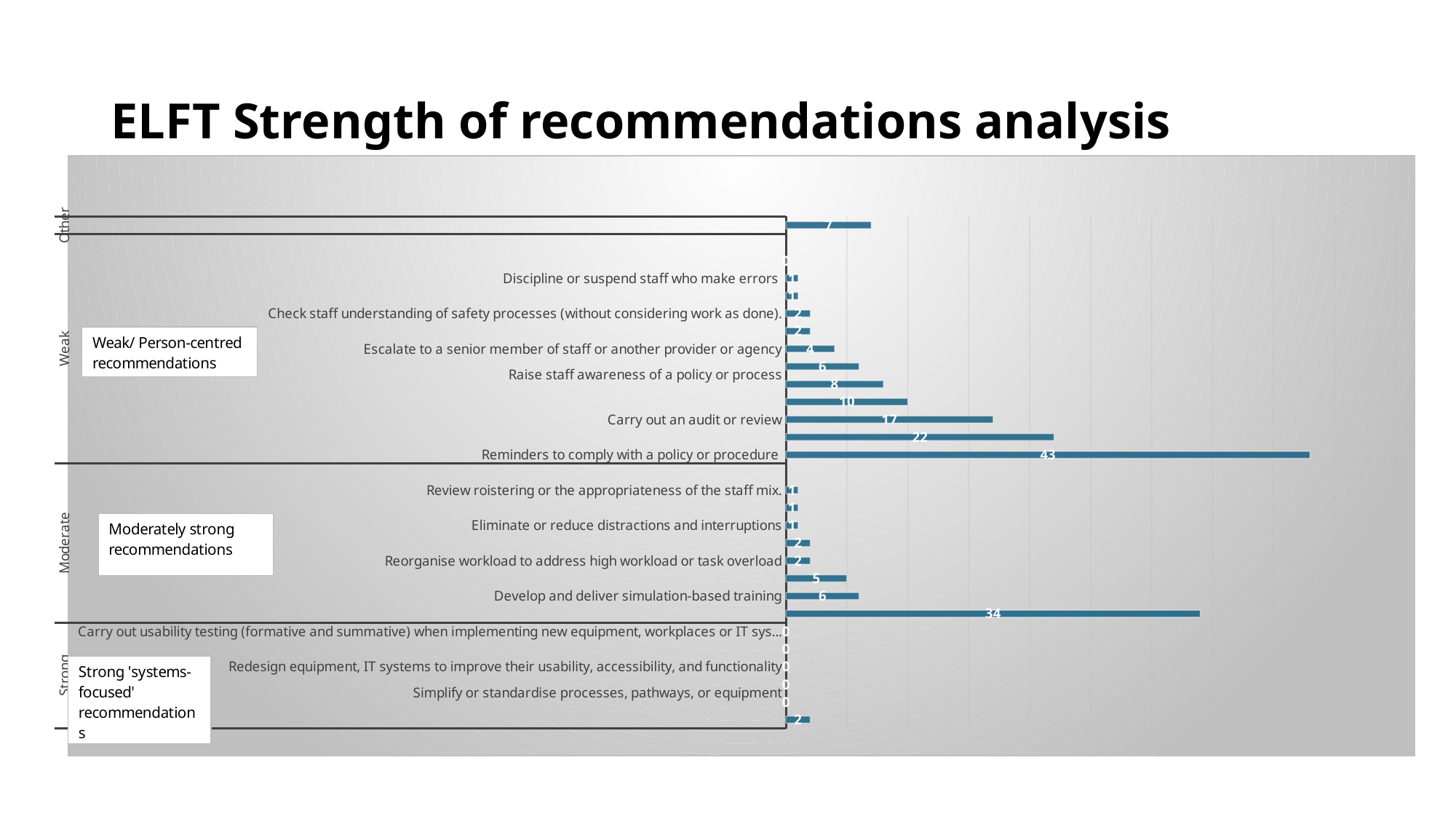
What is the value for 'Simplify or standardise processes, pathways, or equipment'? 0 What is the title of the slide? ELFT Strength of recommendations analysis Which is larger: the value for 'Carry out an audit or review' or the value for 'Escalate to a senior member of staff or another provider or agency'? Carry out an audit or review What is the difference between the values for 'Reminders to comply with a policy or procedure' and 'Carry out an audit or review'? 26 What is the value for 'Escalate to a senior member of staff or another provider or agency'? 4 What is the value for 'Develop and deliver simulation-based training'? 6 What kind of chart is shown on the slide? Bar chart What is the value for 'Check staff understanding of safety processes (without considering work as done).'? 2 What is the value for 'Reminders to comply with a policy or procedure'? 43 Which recommendation has the highest value? Reminders to comply with a policy or procedure What is the value for 'Carry out an audit or review'? 17 What is the difference between the values for 'Develop and deliver simulation-based training' and 'Reorganise workload to address high workload or task overload'? 4